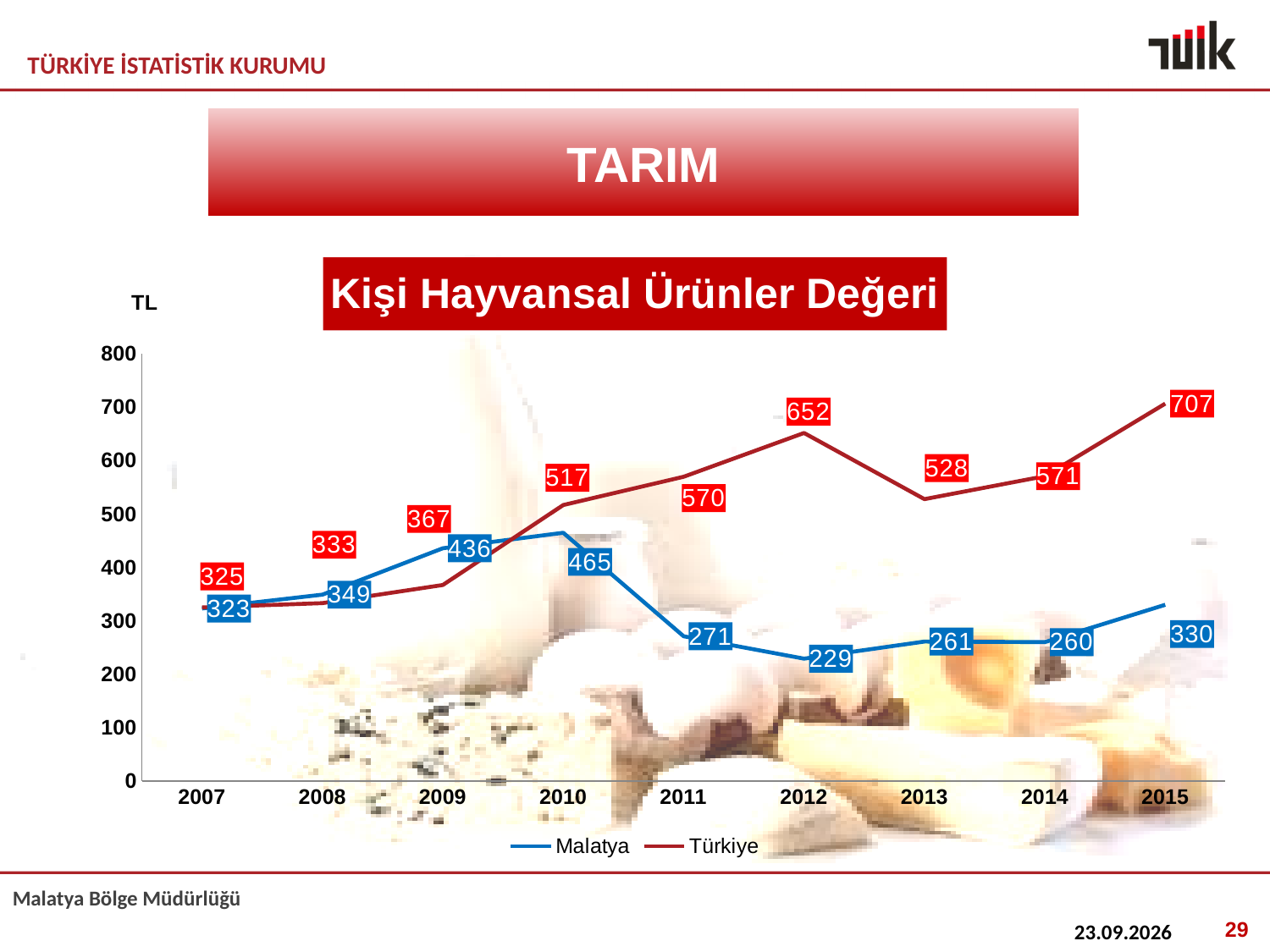
How many years are shown on the x axis? 9 Which series has the larger value in 2009, Malatya or Türkiye? Malatya What is the title of the chart? Kişi Hayvansal Ürünler Değeri What is the difference between the Türkiye and Malatya values in 2015? 377 In which year is the Türkiye value highest? 2015 What kind of chart is shown on the slide? line chart What is the value for Malatya in 2012? 229 What is the value for Türkiye in 2015? 707 Does the Türkiye series generally rise or fall from 2007 to 2015? rise What is the value for Malatya in 2010? 465 In which year is the Malatya value lowest? 2012 How many series does the legend list? 2